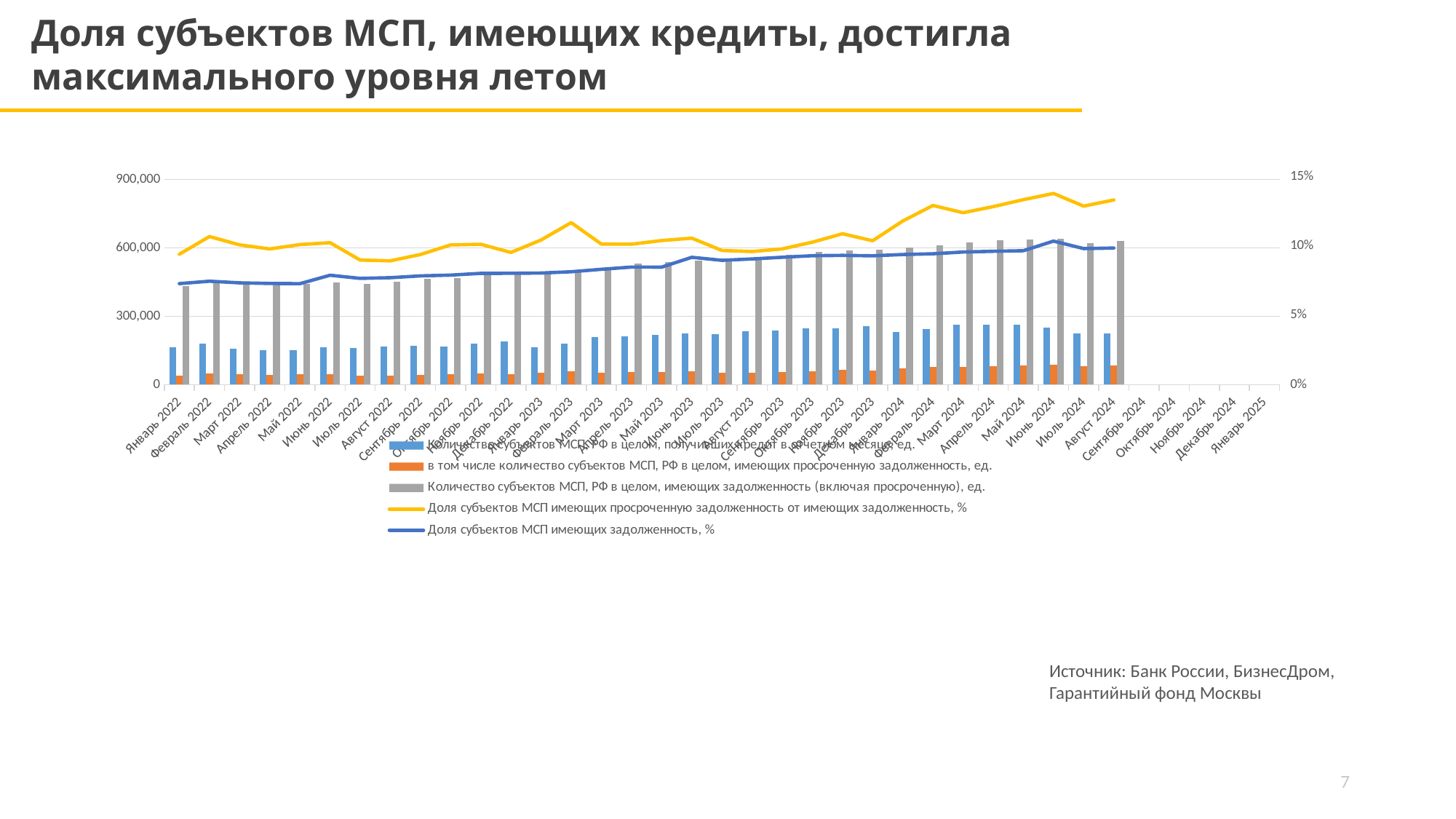
Is the value of the blue line (Доля субъектов МСП имеющих задолженность, %) for Январь 2022 greater or less than 10%? less How many x-axis month labels at the right end of the chart have no plotted data? 5 Is the grey bar (Количество субъектов МСП, РФ в целом, имеющих задолженность) for Январь 2022 greater or less than 600,000? less Is the blue bar (Количество субъектов МСП, РФ в целом, получивших кредит в отчетном месяце) for Январь 2022 greater or less than 300,000? less Does the blue line (Доля субъектов МСП имеющих задолженность, %) generally rise or fall from Январь 2022 to Сентябрь 2024? Rise How many series does the chart legend list? 5 Which is larger: the blue bar for Май 2024 or the blue bar for Январь 2022? Май 2024 Which month has the highest value on the yellow line (Доля субъектов МСП имеющих просроченную задолженность от имеющих задолженность, %)? Июнь 2024 What kind of chart is shown on the slide? A combination bar and line chart What is the maximum value shown on the right-hand percentage axis? 15%